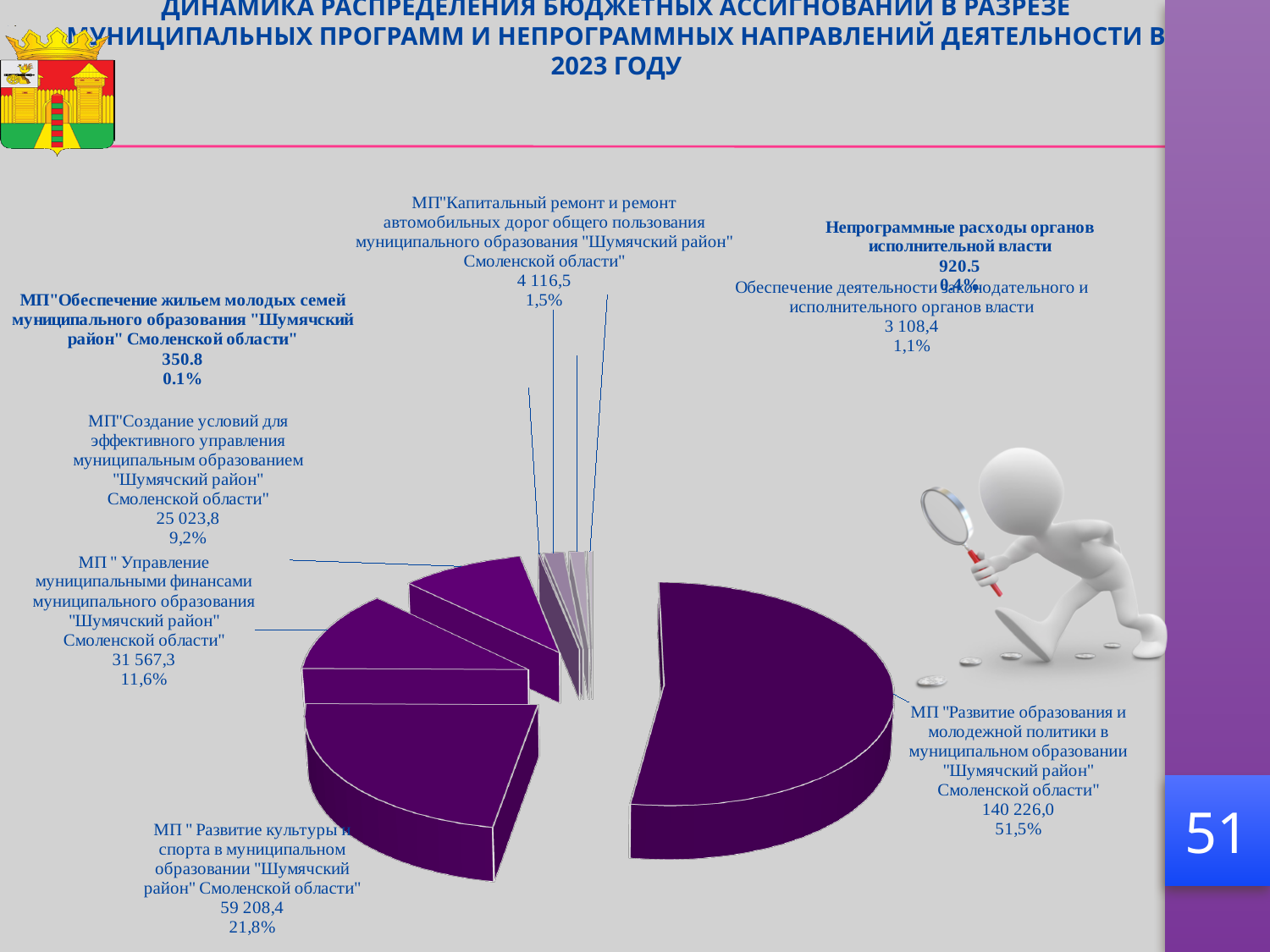
What value is shown for МП "Развитие образования и молодежной политики в муниципальном образовании "Шумячский район" Смоленской области"? 140 226,0 What is the difference between the values for МП "Развитие образования и молодежной политики" (140 226,0) and МП "Развитие культуры и спорта" (59 208,4)? 81 017,6 What share of the pie does МП "Развитие культуры и спорта в муниципальном образовании "Шумячский район" Смоленской области" represent? 21,8% What value is shown for "Обеспечение деятельности законодательного и исполнительного органов власти"? 3 108,4 How many categories (slices) does the pie chart show? 8 What percentage is shown for МП "Создание условий для эффективного управления муниципальным образованием "Шумячский район" Смоленской области"? 9,2% What kind of chart is shown on the slide? Pie chart Which category has the smallest share of the pie? МП "Обеспечение жильем молодых семей муниципального образования "Шумячский район" Смоленской области" What value is shown for МП "Управление муниципальными финансами муниципального образования "Шумячский район" Смоленской области"? 31 567,3 Which category has the largest share of the pie? МП "Развитие образования и молодежной политики в муниципальном образовании "Шумячский район" Смоленской области" What value is shown for МП "Капитальный ремонт и ремонт автомобильных дорог общего пользования муниципального образования "Шумячский район" Смоленской области"? 4 116,5 Which is larger: the value for МП "Управление муниципальными финансами" or the value for МП "Создание условий для эффективного управления муниципальным образованием"? МП "Управление муниципальными финансами"